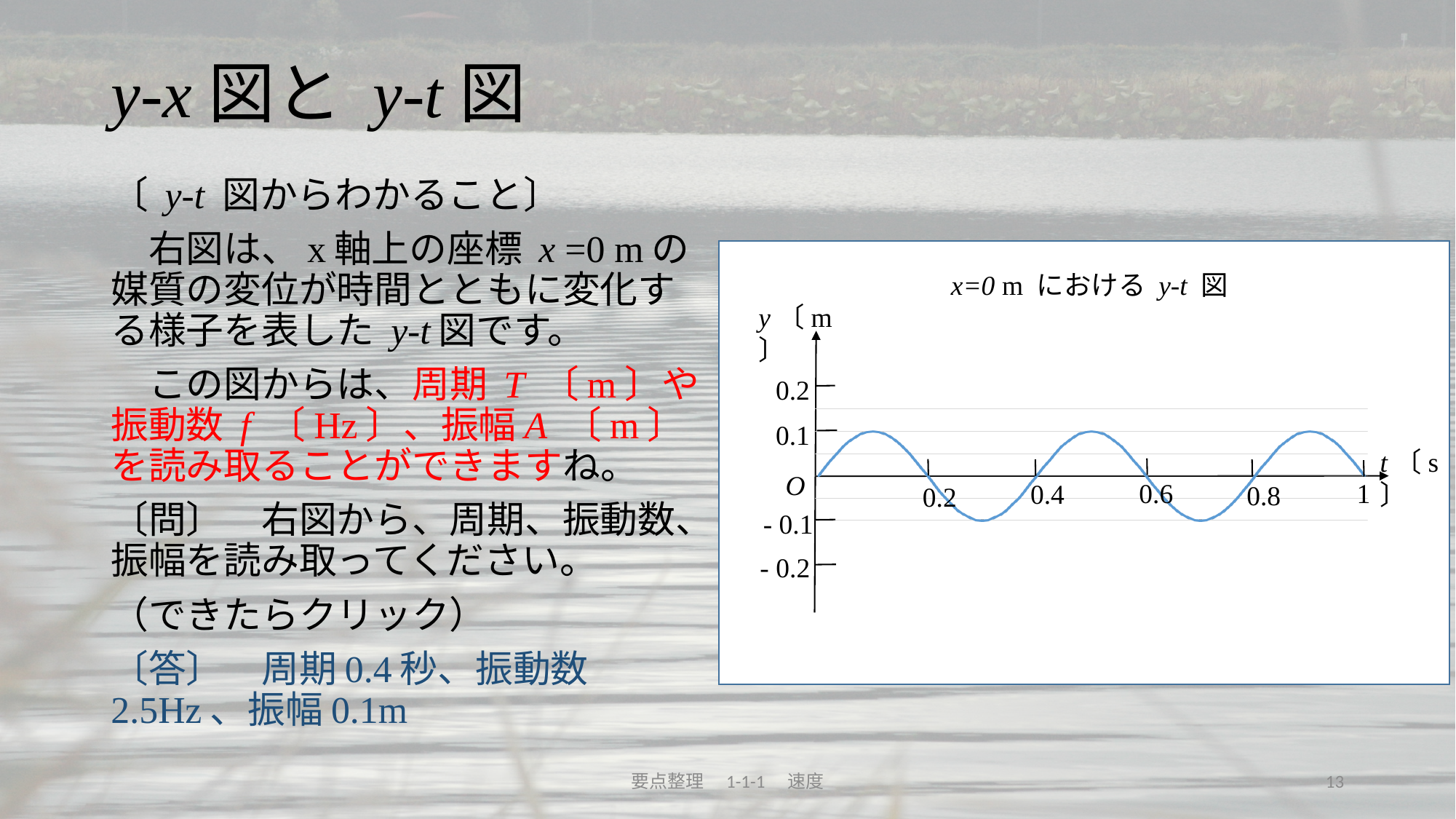
Is the value of y at t = 0.3 s greater or less than 0? less What is the title of the chart? x=0 m における y-t 図 Is the peak value of the curve greater or less than 0.2? less Which is larger, the value of y at t = 0.5 s or at t = 0.7 s? t = 0.5 s What is the minimum value of y reached by the curve? -0.1 What is the maximum value of y reached by the curve? 0.1 Does the curve rise or fall immediately after t = 0? rise Is the value of y at t = 0.1 s greater or less than 0? greater What is the largest tick value shown on the t axis? 1 How many peaks (maxima) does the curve show between t = 0 and t = 1 s? 3 What quantity and unit are shown on the horizontal axis of the chart? t 〔s〕 What kind of chart is shown on the slide? line chart